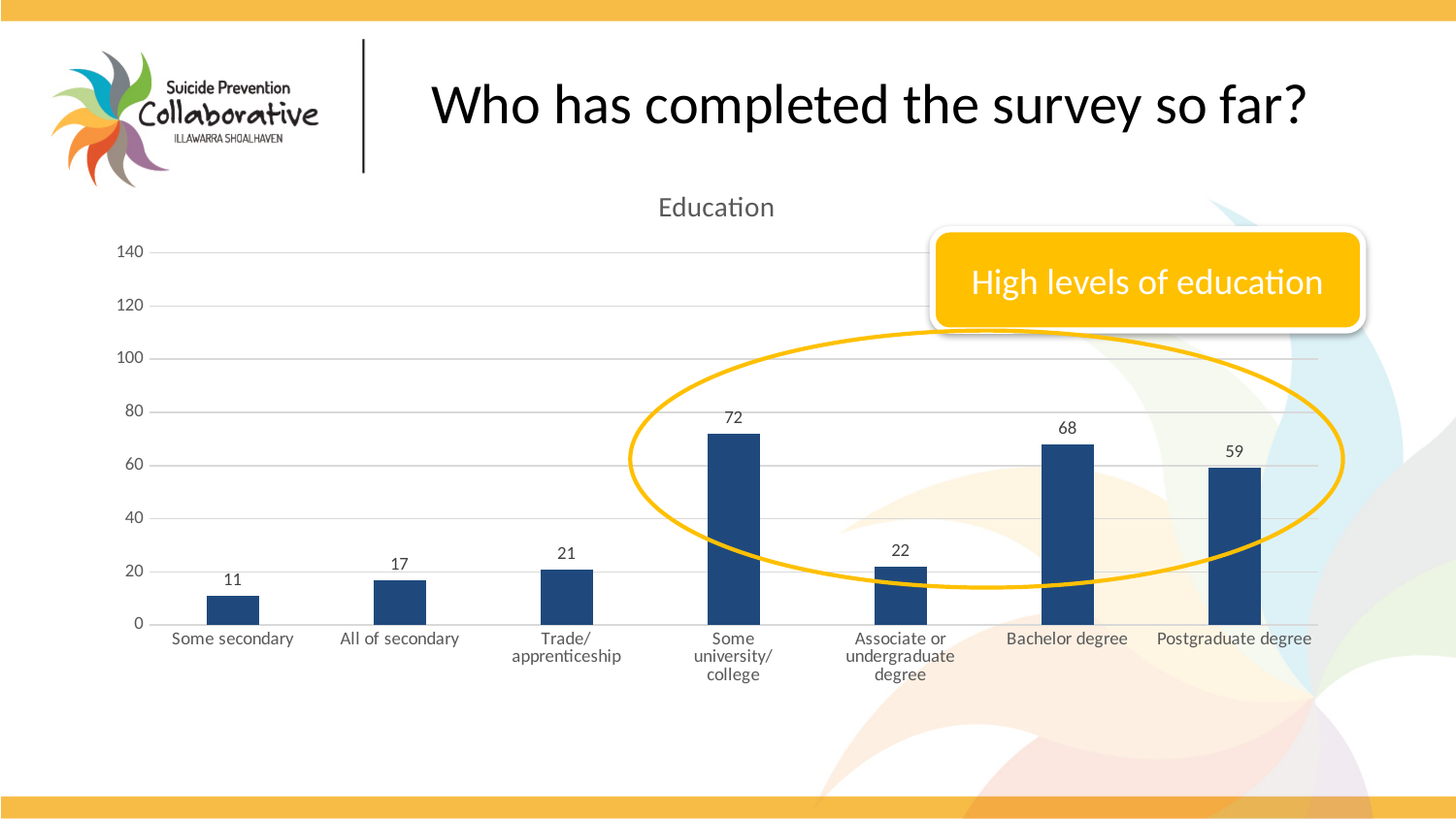
Which is larger, the value for Trade/apprenticeship or the value for All of secondary? Trade/apprenticeship What is the value for Some secondary? 11 What is the value for Associate or undergraduate degree? 22 Which category has the lowest value? Some secondary How many categories are shown on the x axis? 7 What is the title of the chart? Education What is the value for Some university/college? 72 What is the value for Bachelor degree? 68 Which category has the highest value? Some university/college What kind of chart is shown on the slide? Bar chart Is the value for Bachelor degree greater or less than 60? greater What is the difference between the values for Some university/college and Postgraduate degree? 13